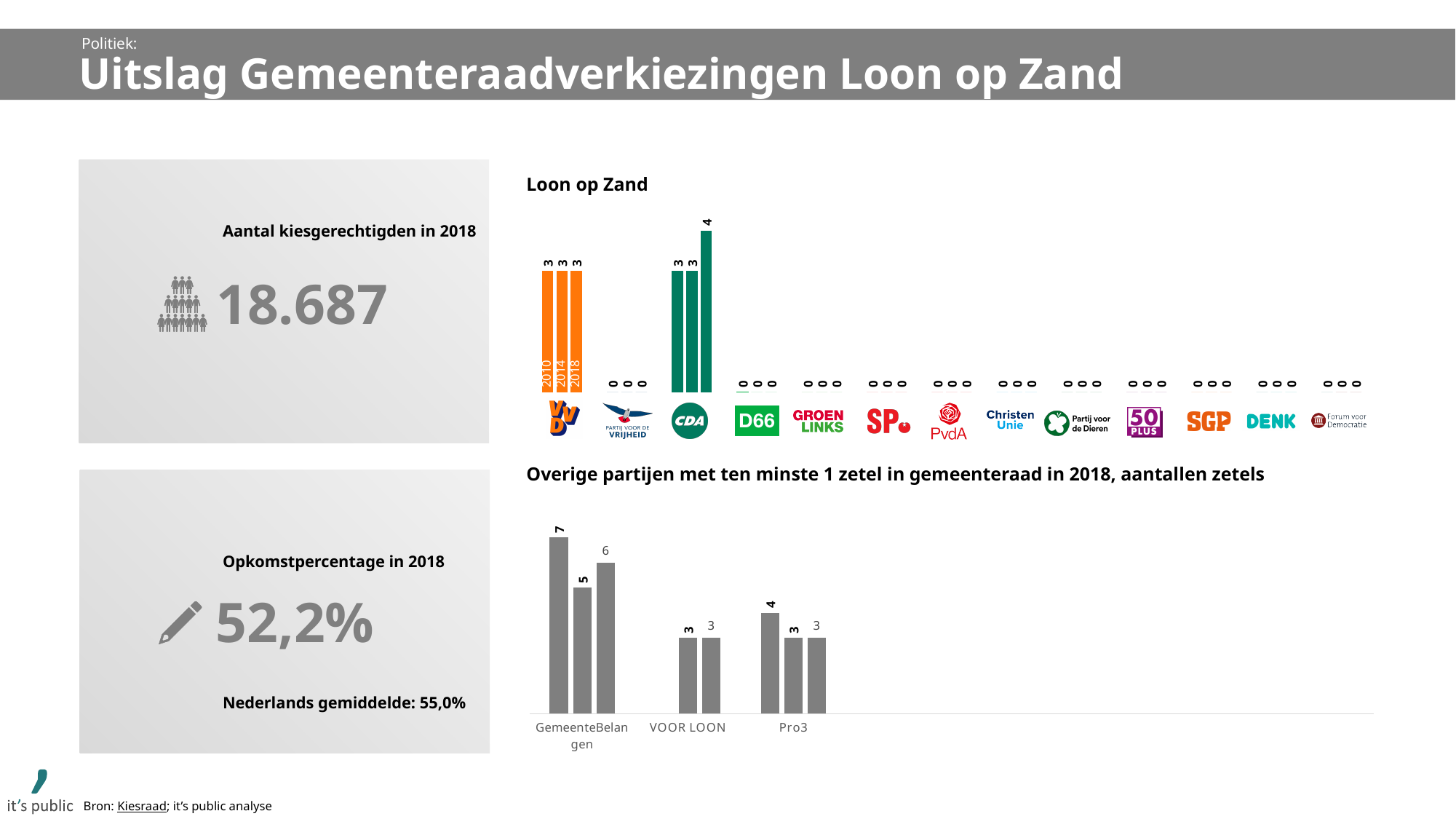
In the 'Loon op Zand' chart, how many seats did CDA win in 2018? 4 In the 'Overige partijen' chart, which party has the highest value? GemeenteBelangen In the 'Loon op Zand' chart, how many seats did D66 win in 2018? 0 In the 'Overige partijen' chart, how many seats did GemeenteBelangen have in 2018? 6 In the 'Loon op Zand' chart, how many seats did VVD win in 2010? 3 In the 'Loon op Zand' chart, what is the difference between CDA's 2018 seats and its 2014 seats? 1 What type of chart is the 'Overige partijen' chart? bar chart In the 'Overige partijen' chart, how many seats did GemeenteBelangen have in 2010? 7 In the 'Overige partijen' chart, which is larger: Pro3's first bar or VOOR LOON's first bar? Pro3's first bar In the 'Overige partijen' chart, what is the difference between GemeenteBelangen's 2010 and 2014 values? 2 In the 'Overige partijen' chart, how many parties are shown on the x axis? 3 In the 'Loon op Zand' chart, which party has the highest value in 2018? CDA